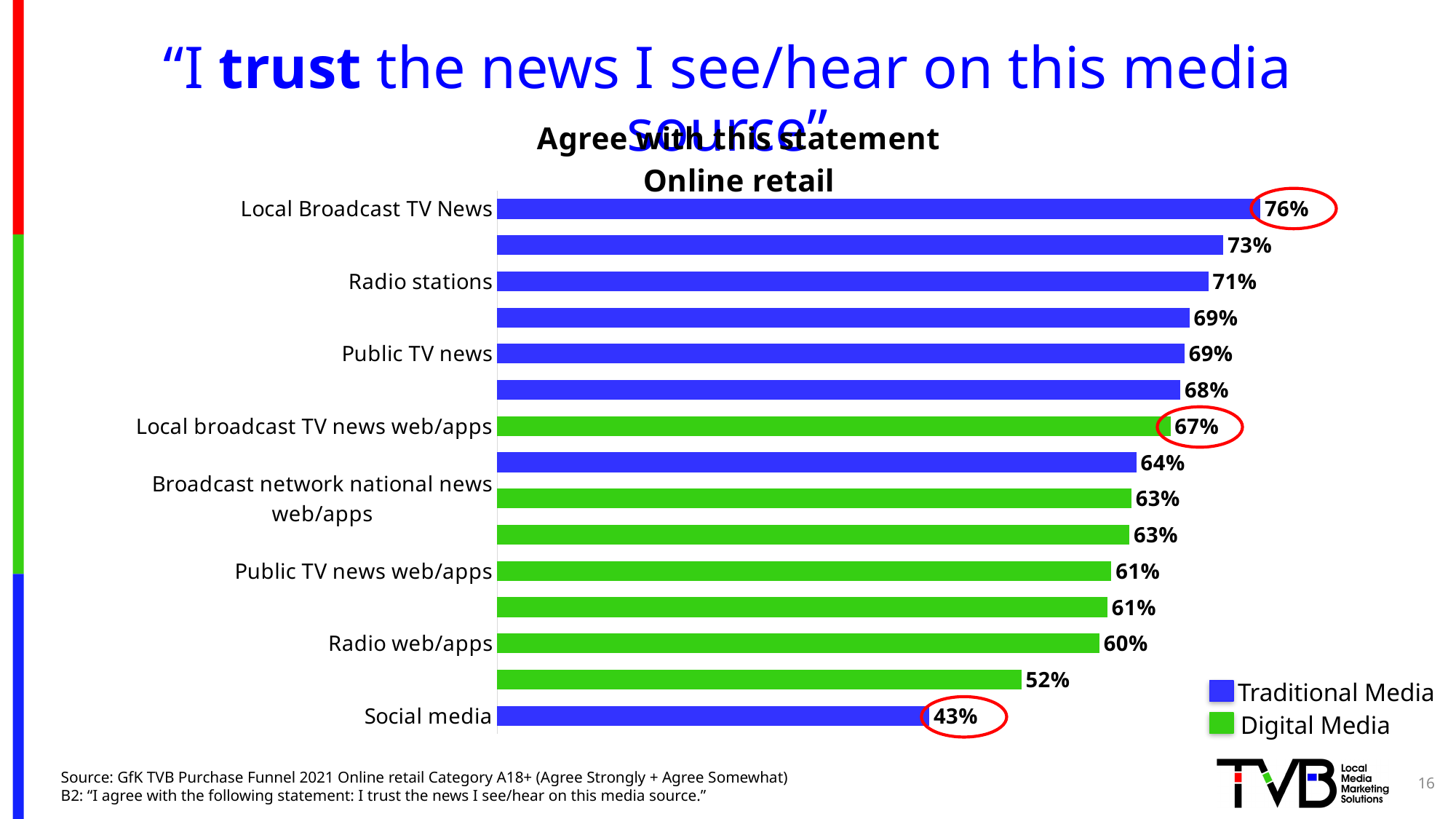
What colour represents Digital Media in the legend? Green Which media source has the lowest percentage agreeing with the statement? Social media What is the value for Local broadcast TV news web/apps? 67% What percentage is shown for Radio web/apps? 60% How many series does the legend list? 2 What percentage is shown for Radio stations? 71% What percentage agree they trust the news on Local Broadcast TV News? 76% Which media source has the highest percentage agreeing with the statement? Local Broadcast TV News Which has a higher value, Radio stations or Radio web/apps? Radio stations What type of chart is shown on the slide? Bar chart What is the difference in percentage points between Local Broadcast TV News and Social media? 33 percentage points What is the value shown for Social media? 43%